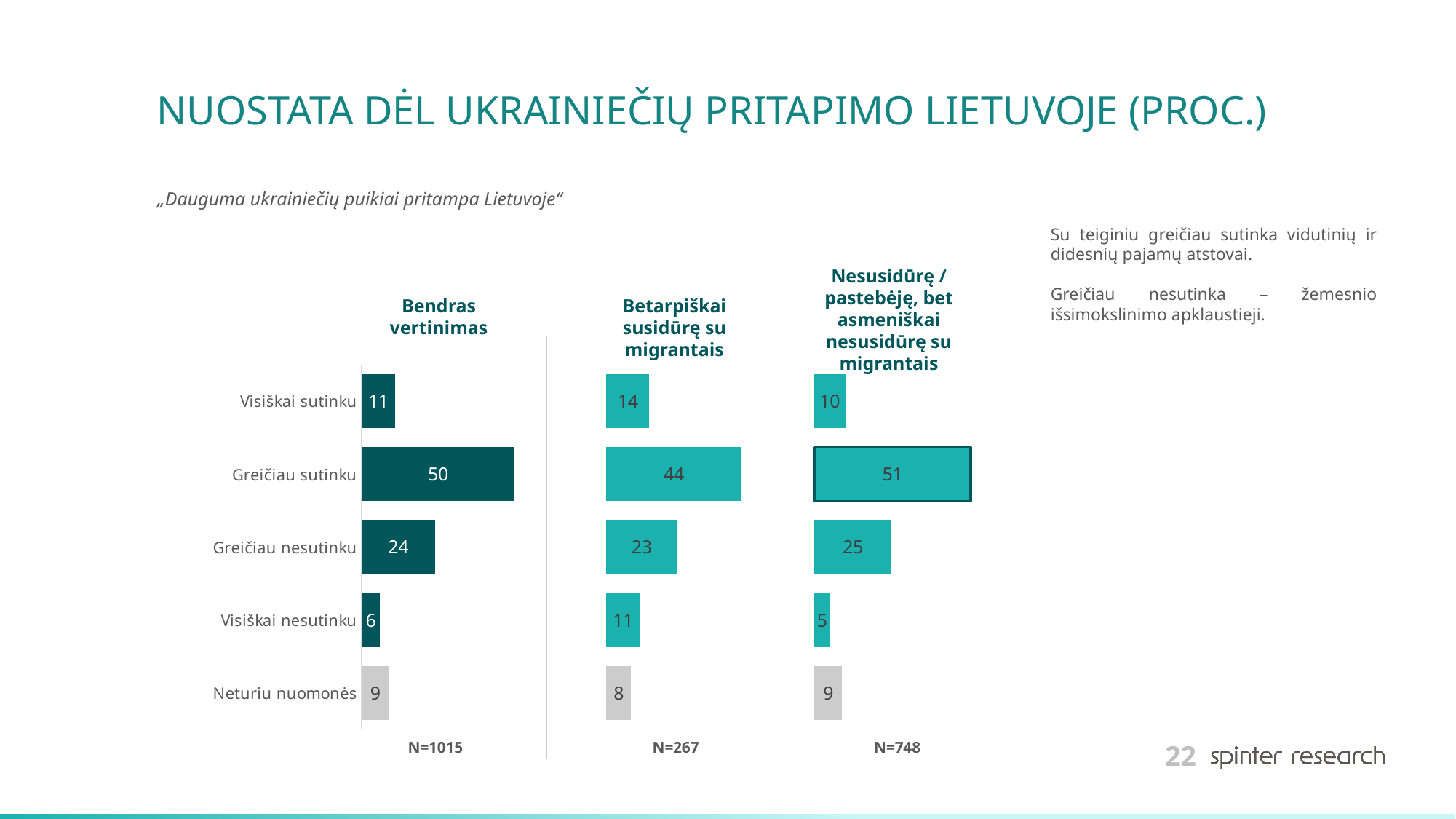
In the "Bendras vertinimas" chart, which category has the highest value? Greičiau sutinku In the "Bendras vertinimas" chart, what is the difference between "Greičiau sutinku" and "Greičiau nesutinku"? 26 What is the difference between "Greičiau sutinku" in the "Nesusidūrę / pastebėję, bet asmeniškai nesusidūrę su migrantais" chart and "Greičiau sutinku" in the "Betarpiškai susidūrę su migrantais" chart? 7 What type of chart is used on this slide? Bar chart In the "Betarpiškai susidūrę su migrantais" chart, what is the value for "Visiškai nesutinku"? 11 In the "Nesusidūrę / pastebėję, bet asmeniškai nesusidūrę su migrantais" chart, what is the value for "Greičiau nesutinku"? 25 In the "Betarpiškai susidūrę su migrantais" chart, which category has the lowest value? Neturiu nuomonės In the "Bendras vertinimas" chart, what is the value for "Greičiau sutinku"? 50 How many categories does the "Bendras vertinimas" chart show? 5 What is the sample size (N) shown under the "Betarpiškai susidūrę su migrantais" chart? N=267 In the "Nesusidūrę / pastebėję, bet asmeniškai nesusidūrę su migrantais" chart, which category has the lowest value? Visiškai nesutinku Which is larger: "Visiškai sutinku" in the "Betarpiškai susidūrę su migrantais" chart or "Visiškai sutinku" in the "Nesusidūrę / pastebėję, bet asmeniškai nesusidūrę su migrantais" chart? Betarpiškai susidūrę su migrantais